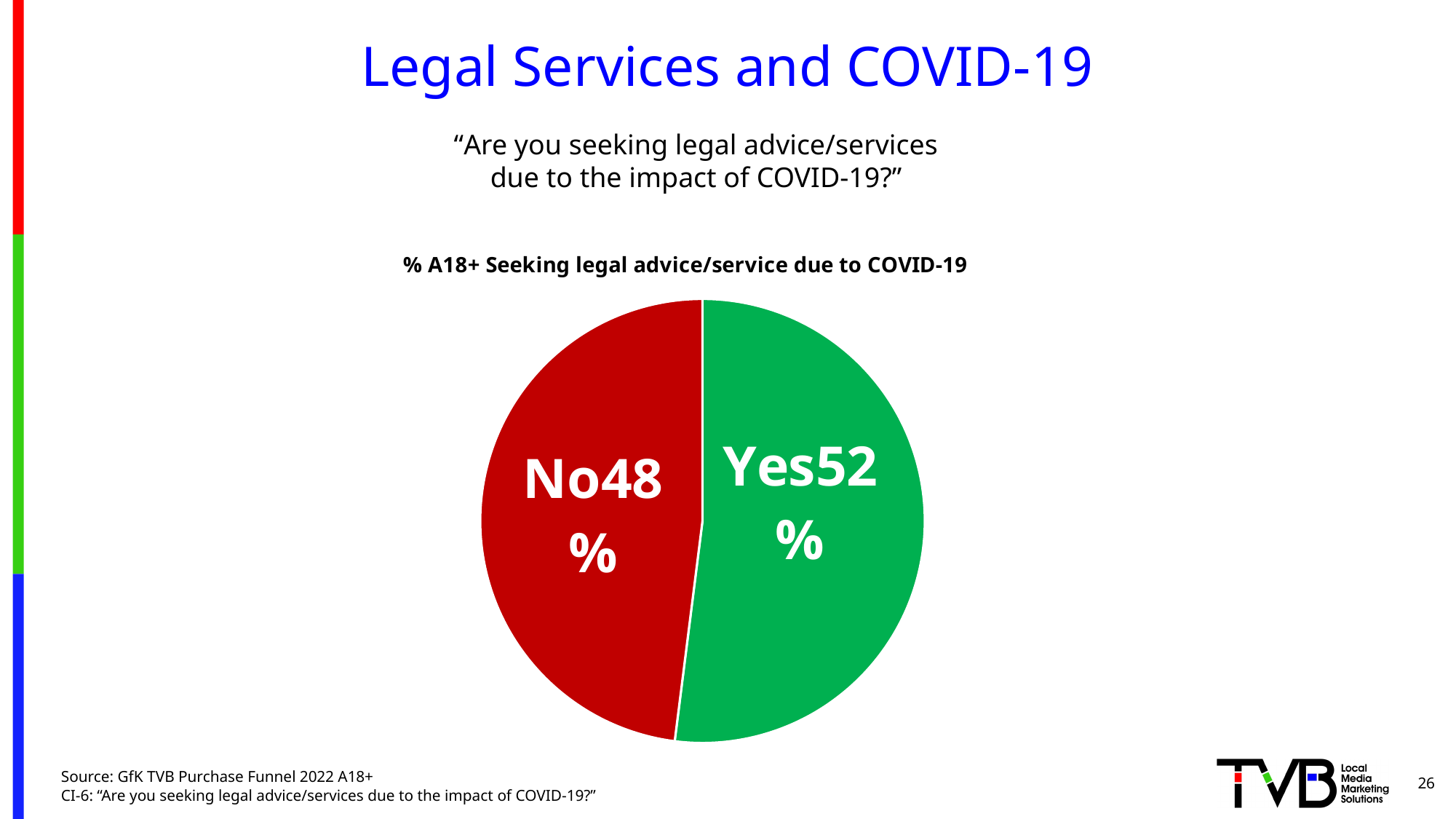
Which response has the smaller share of the pie? No What kind of chart is shown on the slide? pie chart What colour is the No slice of the pie? red What is the title of the chart? % A18+ Seeking legal advice/service due to COVID-19 How many slices does the pie chart have? 2 What share of the pie does the Yes slice represent? 52% Which response has the larger share of the pie, Yes or No? Yes Is the No share greater or less than 50%? less What is the difference in percentage points between the Yes and No shares? 4 What percentage of A18+ answered No to seeking legal advice/services due to COVID-19? 48% What percentage of A18+ answered Yes to seeking legal advice/services due to COVID-19? 52% Is the Yes share larger or smaller than the No share? larger